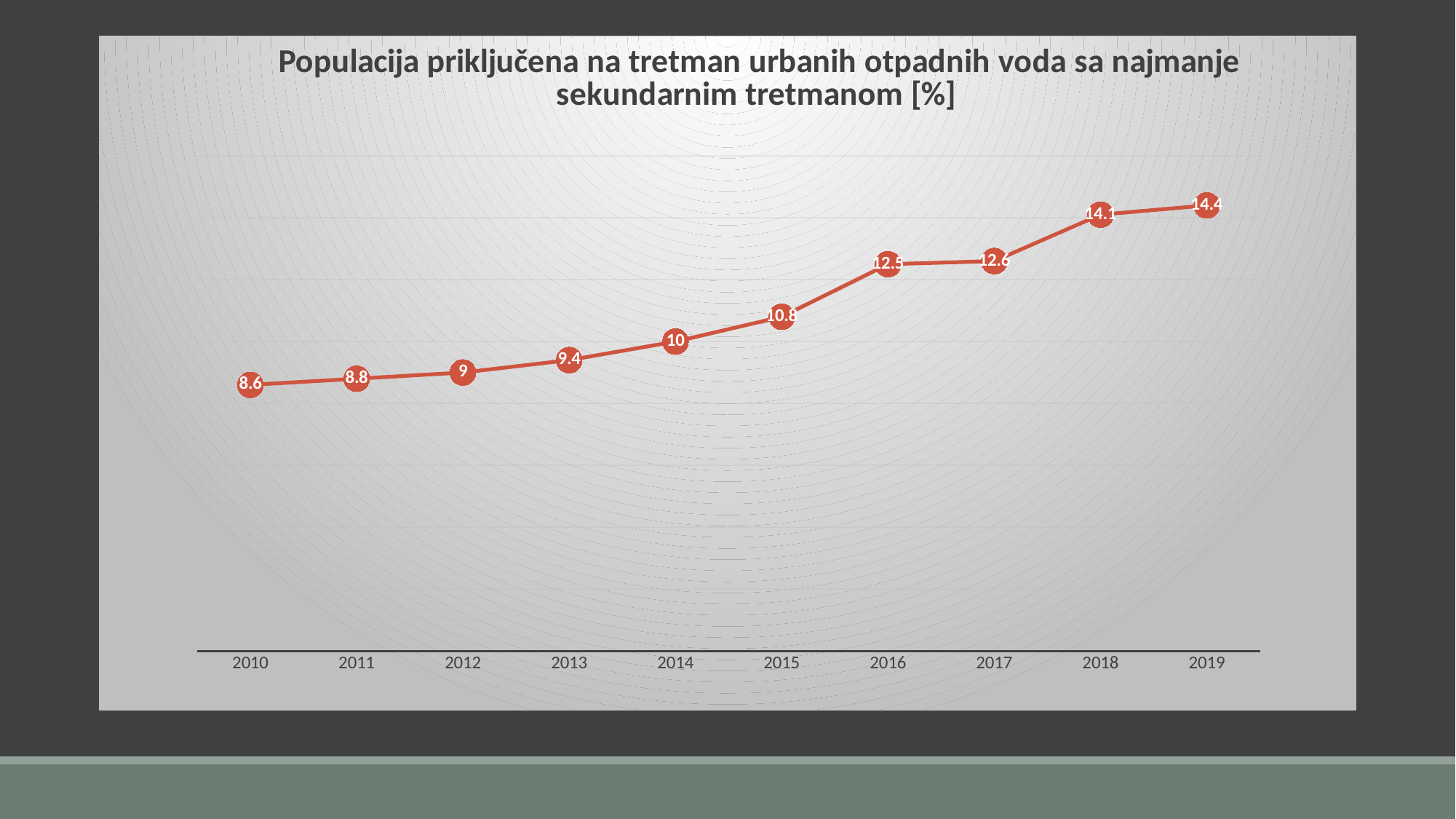
Which is larger, the value for 2014 or the value for 2013? 2014 What is the difference between the values for 2016 and 2015? 1.7 What is the value for 2010? 8.6 How many years are plotted on the chart? 10 What is the value for 2018? 14.1 Which year has the highest value? 2019 What is the title of the chart? Populacija priključena na tretman urbanih otpadnih voda sa najmanje sekundarnim tretmanom [%] What kind of chart is shown on the slide? line chart Do the values rise or fall from 2010 to 2019? rise What is the value for 2015? 10.8 Which year has the lowest value? 2010 What is the difference between the values for 2019 and 2010? 5.8